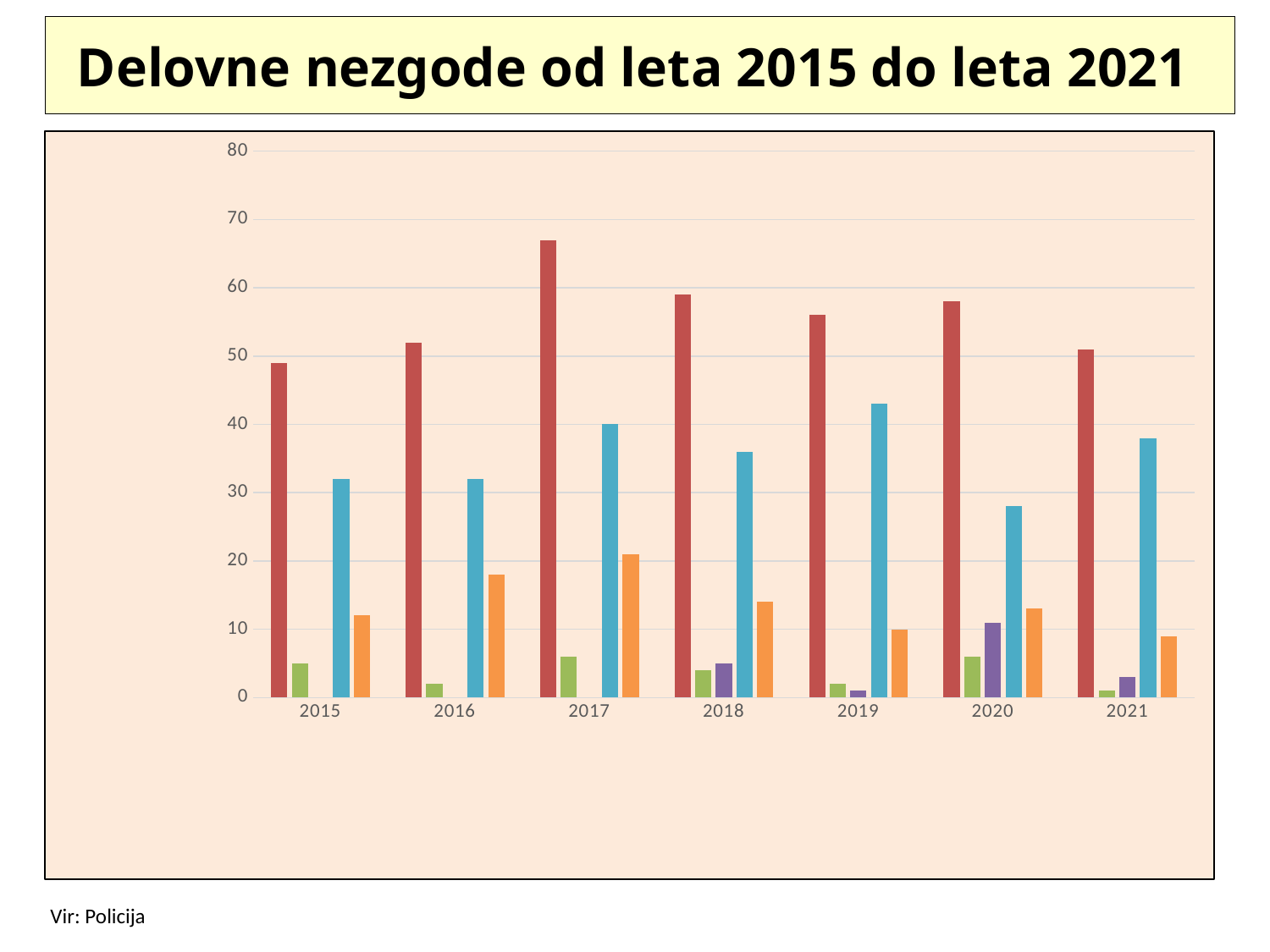
Is the blue bar for 2017 greater or less than 30? greater What source is cited below the chart? Vir: Policija What is the title of the slide above the chart? Delovne nezgode od leta 2015 do leta 2021 In which year is the blue bar the shortest? 2020 Is the red bar for 2017 greater or less than 60? greater Is the orange bar for 2019 greater or less than 20? less In 2019, which is taller, the red bar or the blue bar? the red bar How many years are shown on the x axis of the chart? 7 Do the red bars rise or fall from 2015 to 2017? rise What kind of chart is shown on the slide? bar chart How many bars are plotted for the year 2018? 5 In which year is the red bar the tallest? 2017